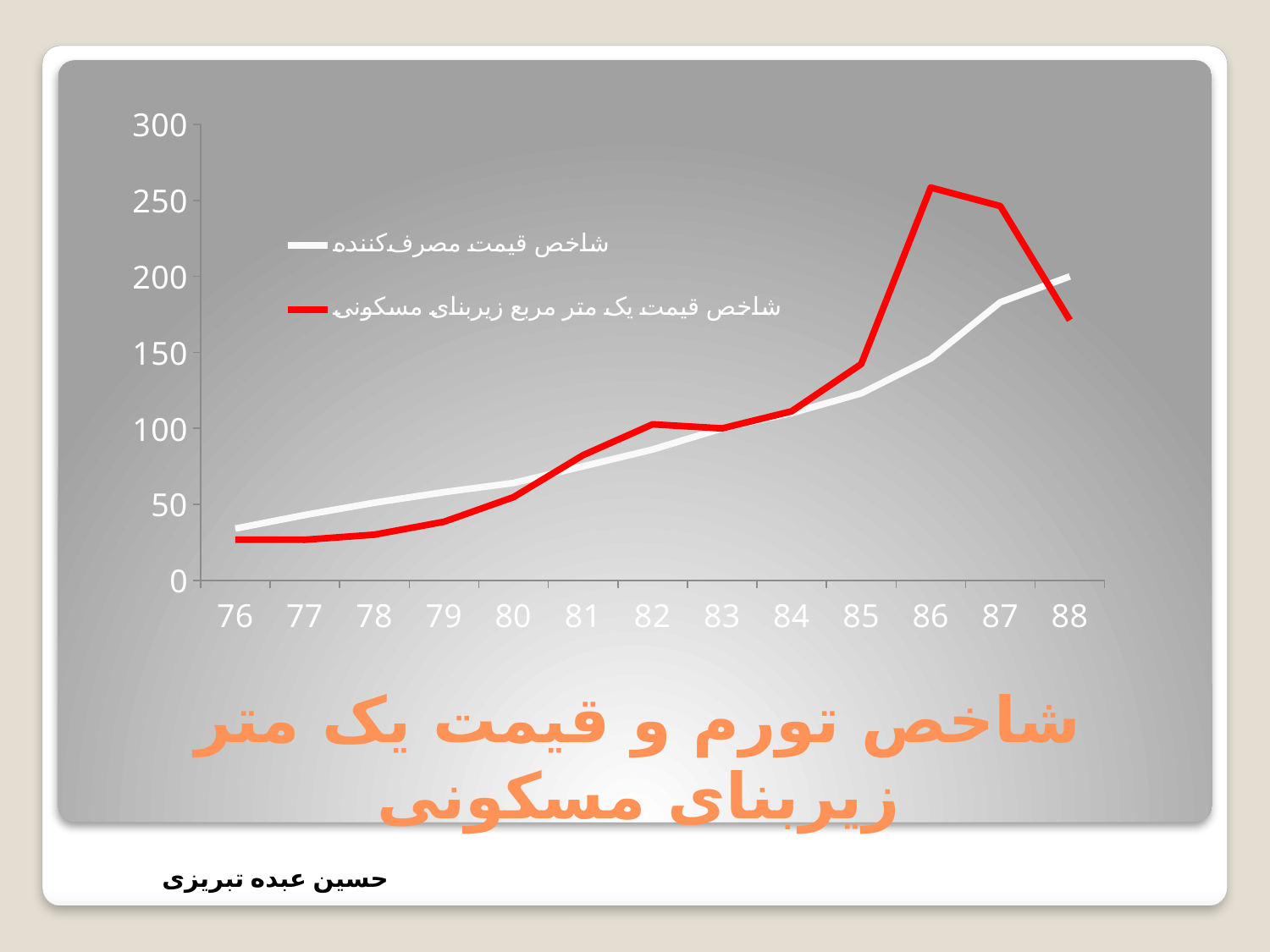
Does the white line (شاخص قیمت مصرف‌کننده) rise or fall from 76 to 88? rise Is the value of the red line in year 86 greater or less than 250? greater Is the value of the red line in year 88 greater or less than 200? less How many years are shown along the x axis? 13 In which year is the white line (شاخص قیمت مصرف‌کننده) at its lowest value? 76 Is the value of the white line in year 76 greater or less than 50? less In which year does the white line (شاخص قیمت مصرف‌کننده) reach its highest value? 88 In year 88, which series has the larger value, the red line or the white line? the white line In year 86, which series has the larger value, the red line or the white line? the red line In which year does the red line (شاخص قیمت یک متر مربع زیربنای مسکونی) reach its highest value? 86 What kind of chart is shown on the slide? line chart How many series does the legend list? 2